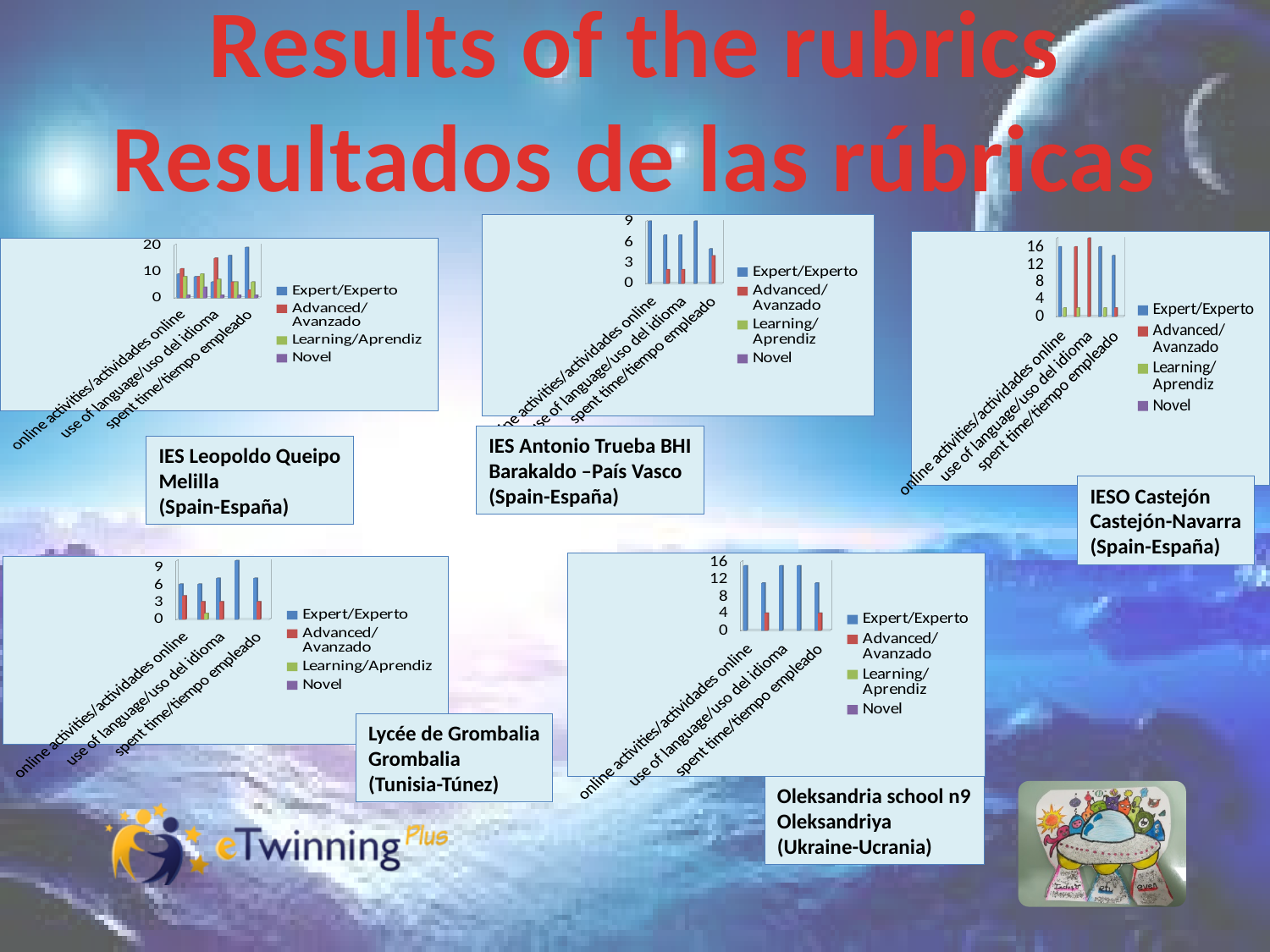
How many series does the legend list in the IES Leopoldo Queipo Melilla chart? 4 In the IES Antonio Trueba BHI Barakaldo chart, is the tallest Expert/Experto bar greater or less than 6? greater What is the highest value shown on the vertical axis of the Oleksandria school n9 chart? 16 How many charts are shown on the slide? 5 How many series does the legend list in the Lycée de Grombalia chart? 4 In the Lycée de Grombalia chart, is the tallest Expert/Experto bar greater or less than 6? greater What is the highest value shown on the vertical axis of the IES Leopoldo Queipo Melilla chart? 20 In the Oleksandria school n9 chart, is the tallest Expert/Experto bar greater or less than 12? greater What kind of chart is shown for IES Antonio Trueba BHI Barakaldo? bar chart